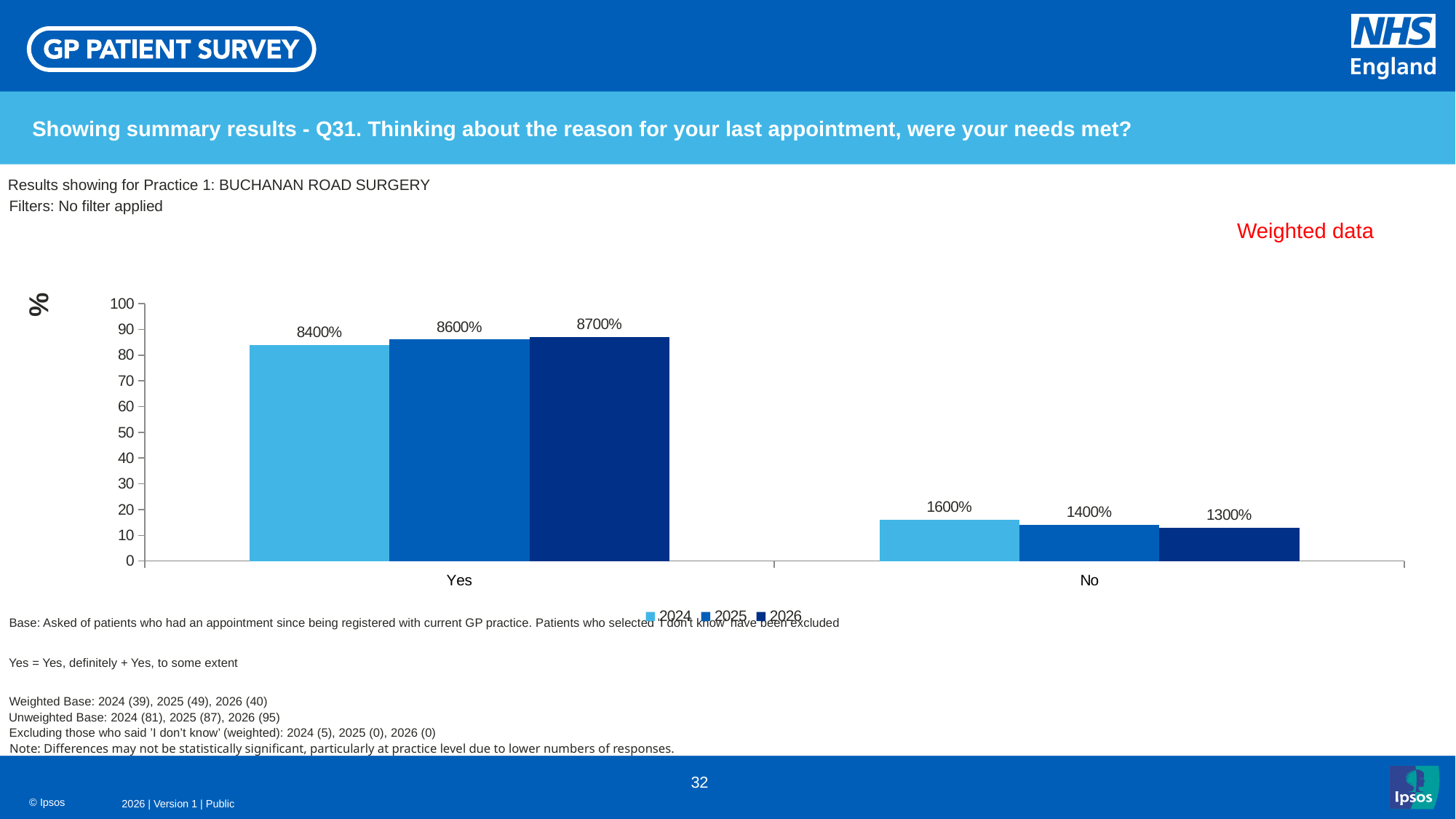
What kind of chart is shown on the slide? bar chart Which year has the lowest bar in the No category? 2026 What is the data label shown for the 2025 series in the Yes category? 8600% Is the 2026 bar in the Yes category greater or less than 80 on the axis? greater Is the 2025 bar in the No category greater or less than 20 on the axis? less What is the data label shown for the 2026 series in the No category? 1300% What is the data label shown for the 2024 series in the Yes category? 8400% How many series does the legend list? 3 Which is larger in the No category, the 2024 bar or the 2025 bar? 2024 How many categories are shown on the x axis? 2 Which year has the highest bar in the Yes category? 2026 What is the data label shown for the 2024 series in the No category? 1600%